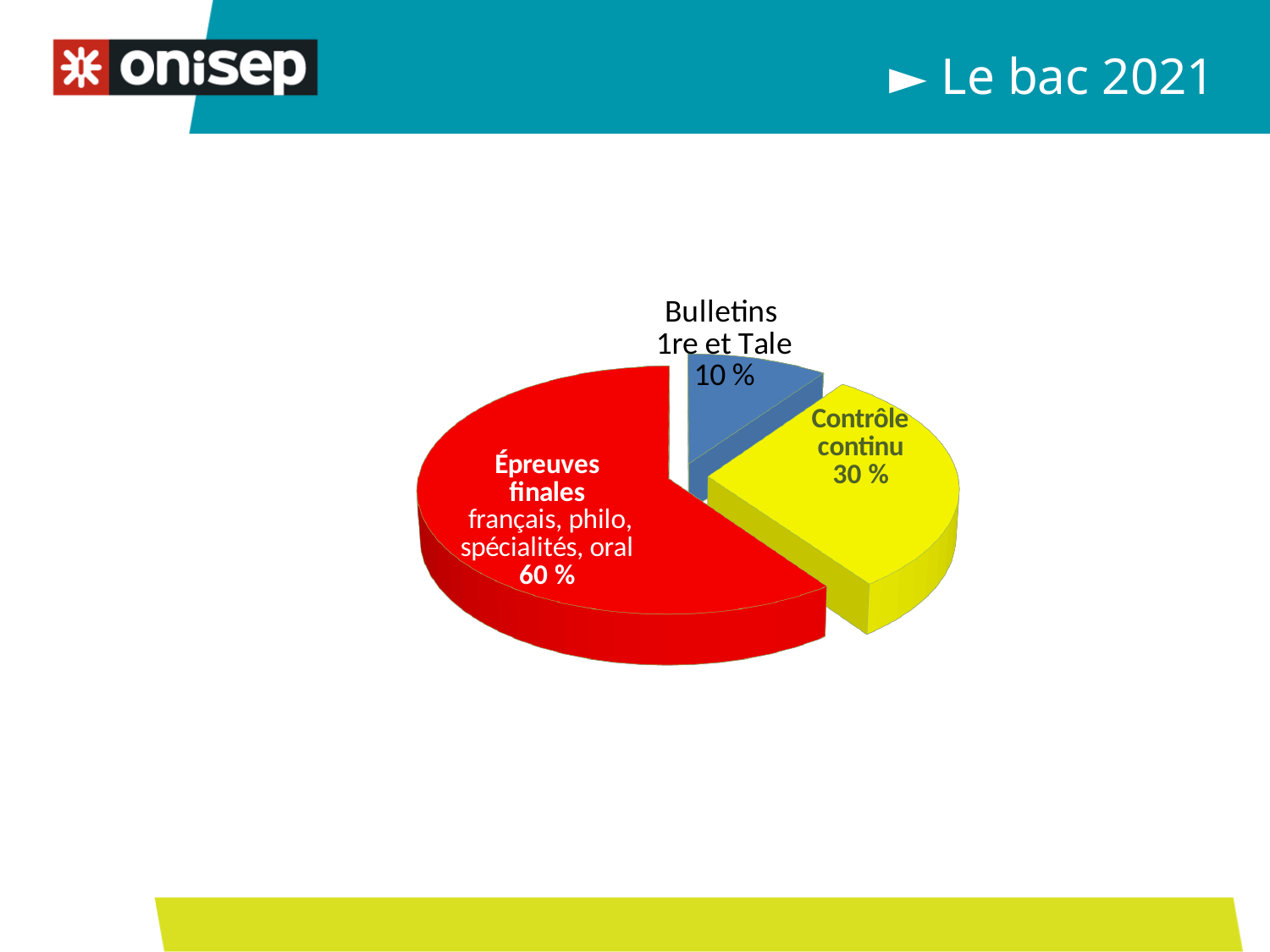
What is the difference between the shares for Contrôle continu and Bulletins 1re et Tale? 20 % What share of the pie is labelled "Bulletins 1re et Tale"? 10 % What kind of chart is shown on the slide? pie chart What colour is the Contrôle continu slice? yellow How many slices does the pie chart have? 3 What is the difference between the shares for Épreuves finales and Contrôle continu? 30 % Which is larger, the share for Contrôle continu or the share for Bulletins 1re et Tale? Contrôle continu What colour is the Épreuves finales slice? red What share of the pie is labelled "Épreuves finales"? 60 % Which slice of the pie is the smallest? Bulletins 1re et Tale Which slice of the pie is the largest? Épreuves finales What share of the pie is labelled "Contrôle continu"? 30 %